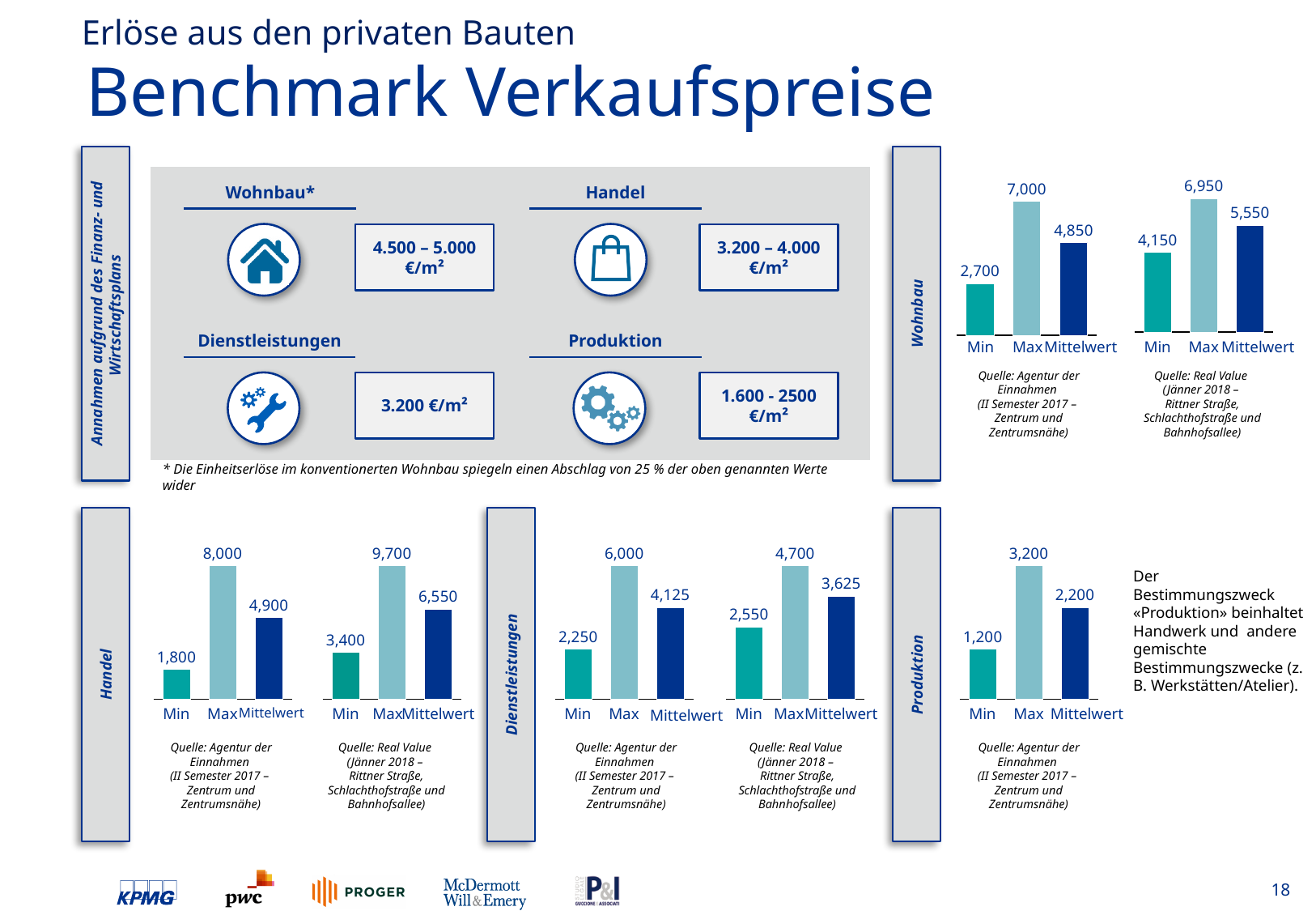
Which is larger: the Max value in the Handel chart from Real Value or the Max value in the Handel chart from Agentur der Einnahmen? Real Value (9,700) In the Produktion chart, what is the difference between Mittelwert and Min? 1,000 In the Wohnbau chart sourced from Real Value, what is the difference between Max and Mittelwert? 1,400 In the Wohnbau chart sourced from Real Value, what is the value for Mittelwert? 5,550 What type of chart is used for the Wohnbau data? Bar chart In the Wohnbau chart sourced from Agentur der Einnahmen, what is the value for Max? 7,000 In the Handel chart sourced from Real Value, what is the value for Min? 3,400 In the Dienstleistungen chart sourced from Real Value, what is the value for Mittelwert? 3,625 In the Produktion chart, what is the value for Max? 3,200 In the Handel chart sourced from Agentur der Einnahmen, what is the difference between Max and Min? 6,200 How many categories are shown in the Produktion chart? 3 In the Dienstleistungen chart sourced from Agentur der Einnahmen, which category has the lowest value? Min